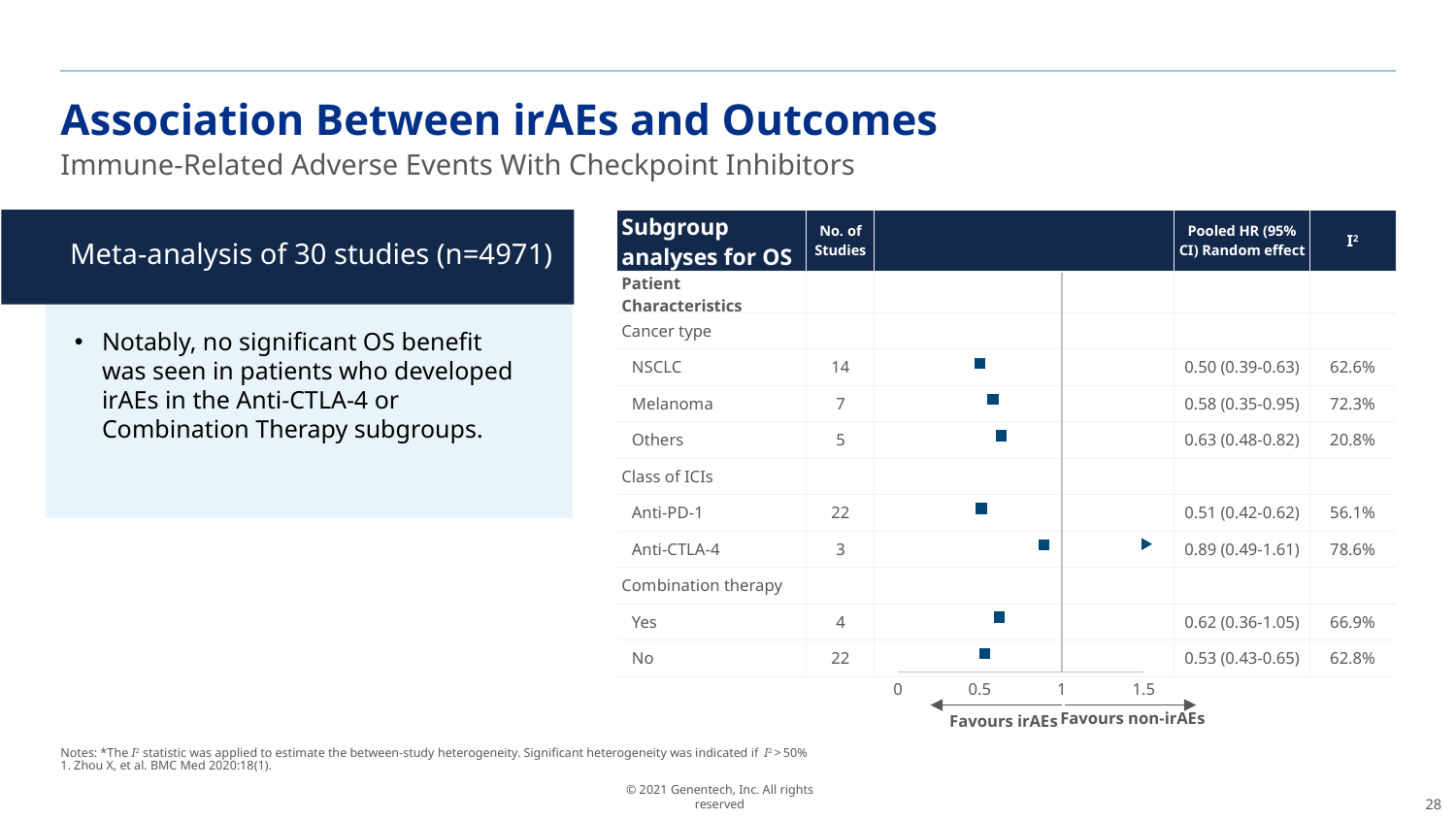
What is the difference in I² between the Anti-CTLA-4 and Anti-PD-1 subgroups? 22.5% What is the pooled HR (95% CI) for the NSCLC subgroup? 0.50 (0.39-0.63) Which subgroup has the highest pooled HR? Anti-CTLA-4 How many studies are included in the Anti-PD-1 subgroup? 22 Which has the larger pooled HR, Melanoma or Others? Others Is the pooled HR point estimate for Anti-CTLA-4 greater or less than 1? less Which subgroup has the fewest studies? Anti-CTLA-4 Which subgroup has the lowest pooled HR? NSCLC What do the arrows below the x axis indicate for values to the left and right of 1? Favours irAEs (left), Favours non-irAEs (right) Which subgroup has the lowest I² value? Others What is the I² value for the Melanoma subgroup? 72.3% How many subgroups have a pooled HR plotted in the forest plot? 7